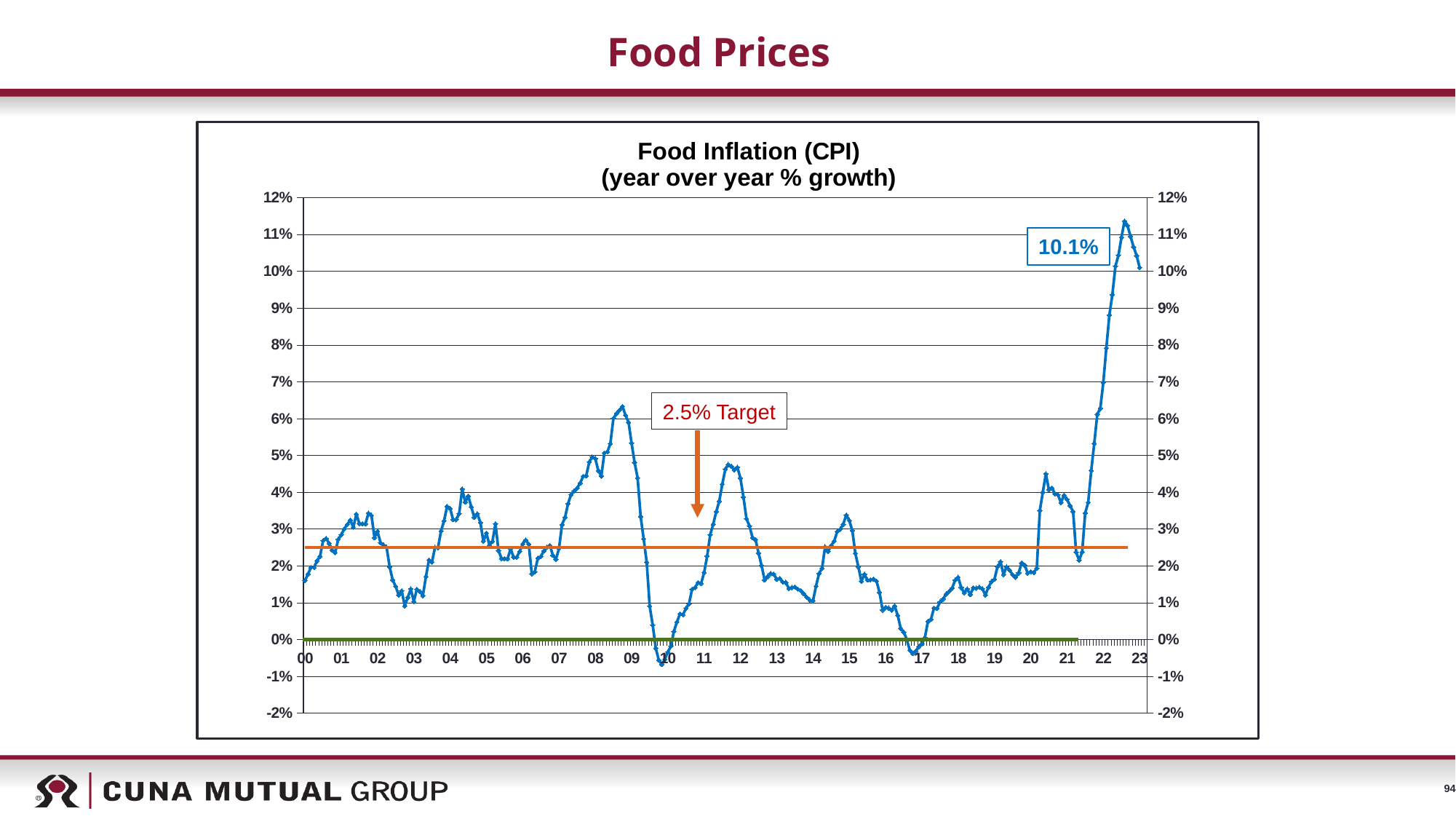
Is the value of food inflation at the start of 2000 greater or less than 2%? less How many year labels are shown on the x axis? 24 Does food inflation rise or fall from 2021 to 2022? rise What is the most recent food inflation value labeled on the chart? 10.1% Is the lowest value of food inflation around 2009-2010 greater or less than 0%? less What is the title of the chart? Food Inflation (CPI) (year over year % growth) Is the peak value of food inflation in 2008 greater or less than 6%? greater In which year does food inflation reach its highest value on the chart? 2022 What target level is marked by the horizontal orange line? 2.5% Target What kind of chart is shown on the slide? line chart Which is larger, the peak of food inflation in 2008 or the peak in 2011? 2008